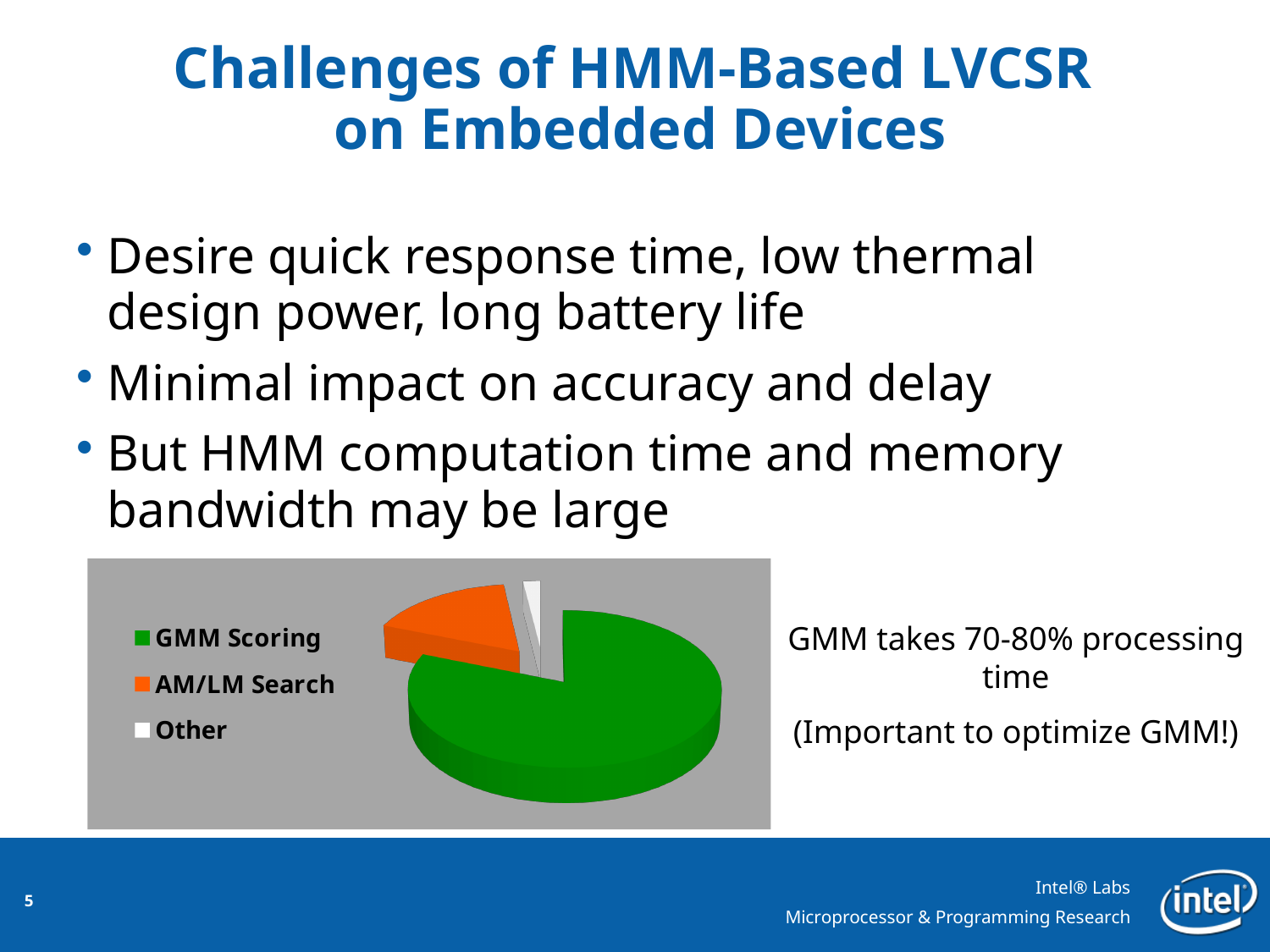
Which slice is larger in the pie chart, GMM Scoring or AM/LM Search? GMM Scoring Which category has the largest slice of the pie chart? GMM Scoring Which slice is larger in the pie chart, AM/LM Search or Other? AM/LM Search Which category is shown in orange in the pie chart? AM/LM Search How many entries does the pie chart's legend list? 3 How many slices does the pie chart have? 3 Which slice is smaller in the pie chart, Other or GMM Scoring? Other What kind of chart is shown on the slide? Pie chart What colour is the GMM Scoring slice in the pie chart? Green Which category has the smallest slice of the pie chart? Other